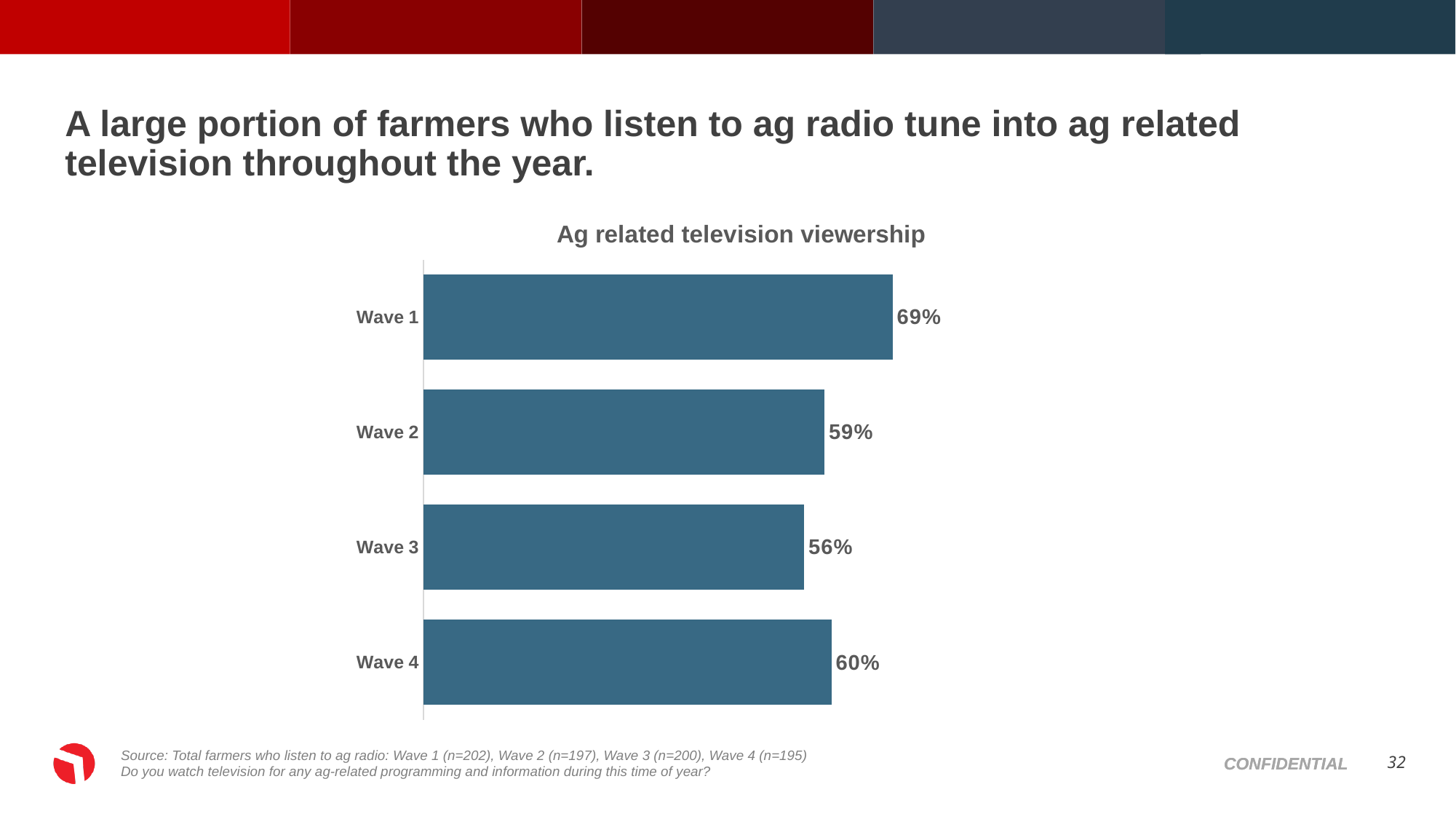
Which is larger, the value for Wave 2 or the value for Wave 4? Wave 4 How many waves are shown in the chart? 4 What is the title of the chart? Ag related television viewership Which wave has the highest ag related television viewership? Wave 1 What is the difference between the values for Wave 4 and Wave 3? 4% What is the difference between the values for Wave 1 and Wave 2? 10% Does the viewership rise or fall from Wave 1 to Wave 3? Fall Which wave has the lowest ag related television viewership? Wave 3 What is the value for Wave 1? 69% What is the value for Wave 3? 56% What kind of chart is shown on the slide? Bar chart What is the value for Wave 4? 60%